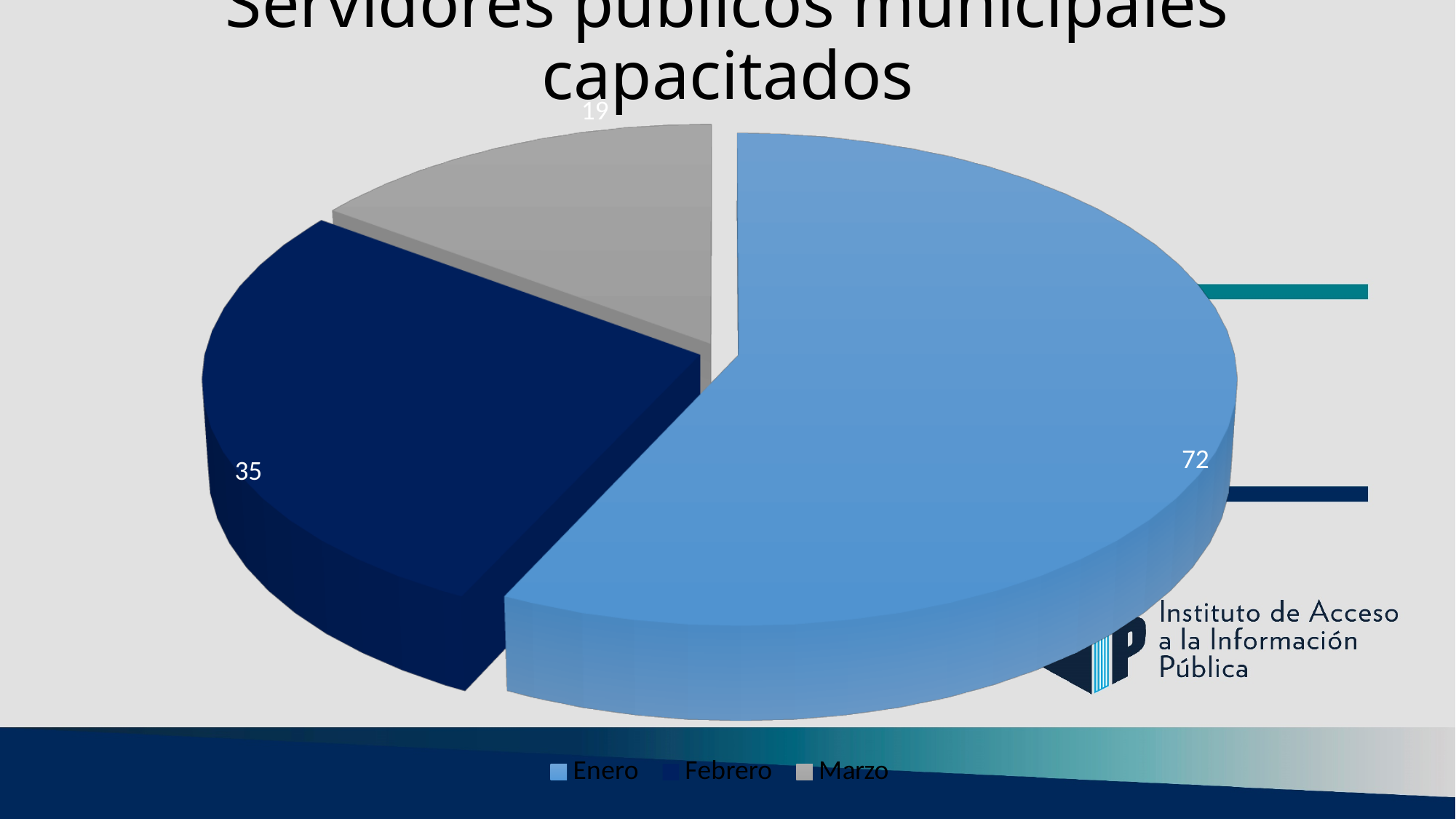
How many slices does the pie chart have? 3 Which month has the largest slice? Enero What is the title of the chart? Servidores públicos municipales capacitados What is the value for Enero? 72 Which is larger, the value for Febrero or the value for Marzo? Febrero Which month has the smallest slice? Marzo What is the total of all the slices in the pie chart? 126 What is the difference between the values for Febrero and Marzo? 16 What kind of chart is shown on the slide? Pie chart What is the value for Marzo? 19 What is the value for Febrero? 35 What is the difference between the values for Enero and Febrero? 37